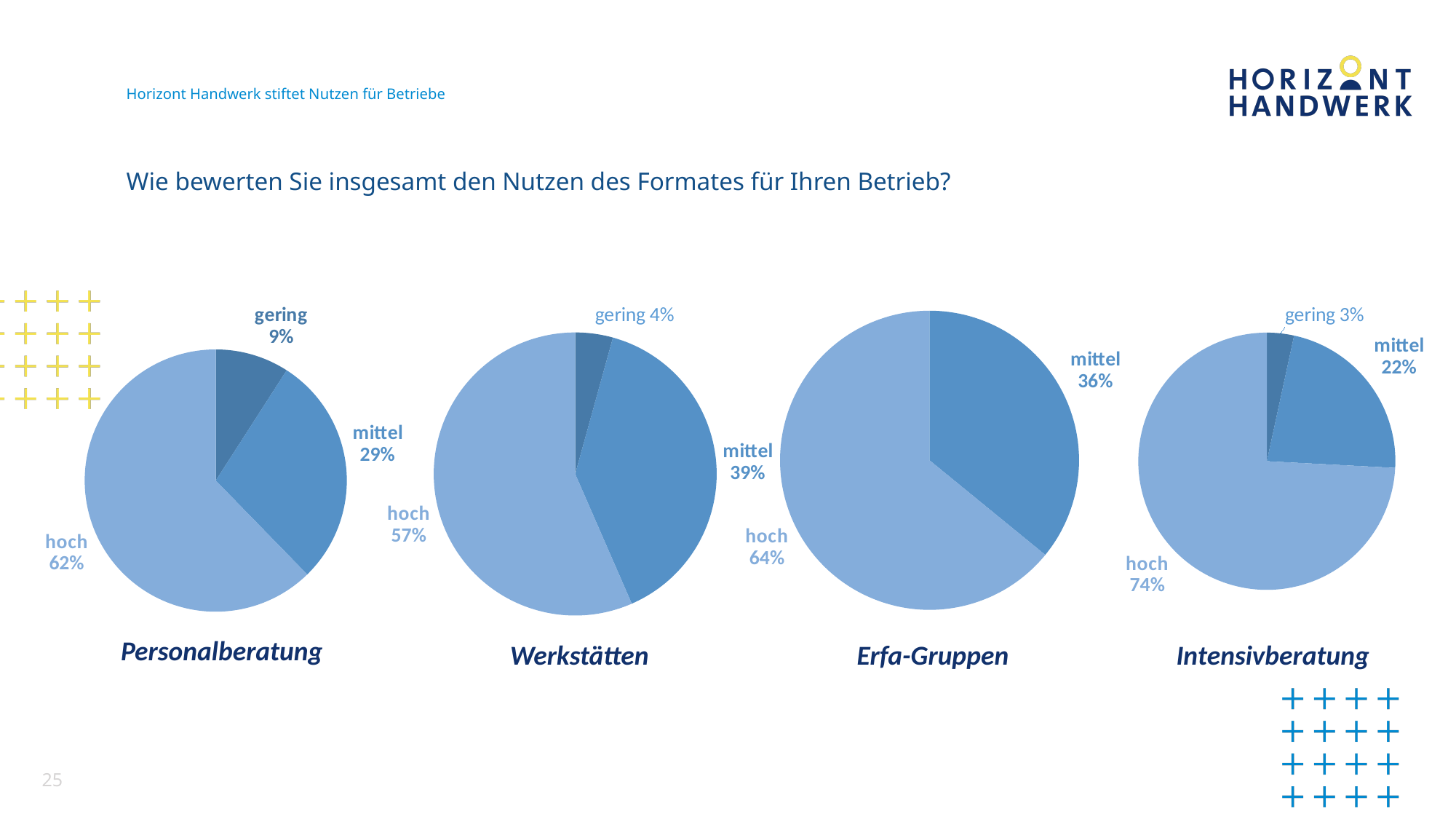
In the Werkstätten pie chart, which category has the smallest share? gering In the Personalberatung pie chart, which category has the largest share? hoch How many slices does the Erfa-Gruppen pie chart have? 2 Which is larger: the 'mittel' share in the Werkstätten pie chart or the 'mittel' share in the Erfa-Gruppen pie chart? Werkstätten In the Intensivberatung pie chart, what is the difference between the 'hoch' and 'mittel' shares? 52% In the Personalberatung pie chart, what share is labelled 'hoch'? 62% What type of chart is used for Personalberatung? pie chart In the Intensivberatung pie chart, what share is labelled 'hoch'? 74% Which pie chart on the slide has the largest 'hoch' share? Intensivberatung In the Werkstätten pie chart, what share is labelled 'gering'? 4% In the Erfa-Gruppen pie chart, what share is labelled 'mittel'? 36% How many pie charts are shown on the slide? 4